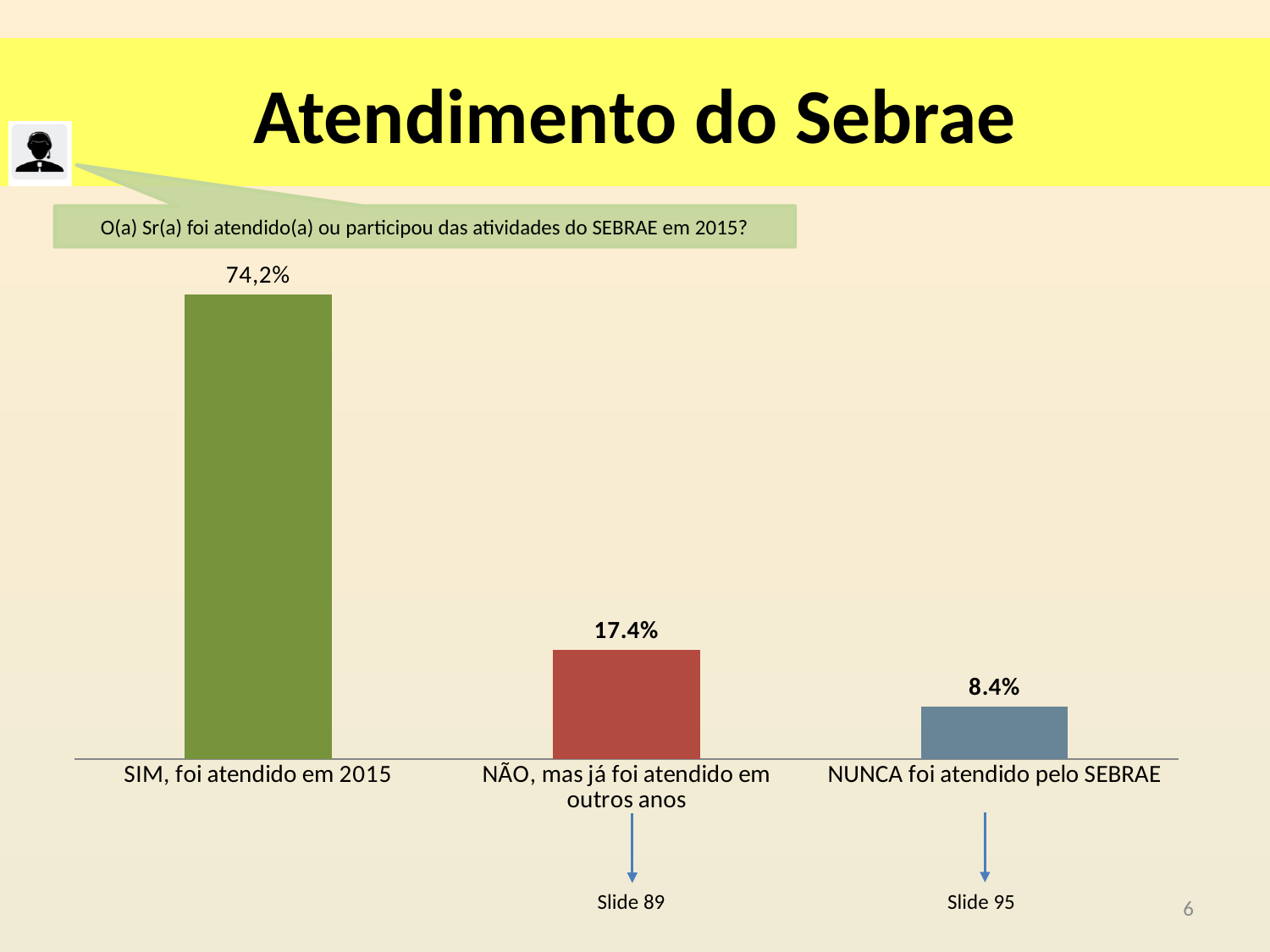
What colour is the bar for "SIM, foi atendido em 2015"? Green What kind of chart is shown on the slide? Bar chart Do the values rise or fall from left to right across the categories? Fall How many categories are shown in the chart? 3 Which is larger, the value for "NÃO, mas já foi atendido em outros anos" or the value for "NUNCA foi atendido pelo SEBRAE"? NÃO, mas já foi atendido em outros anos Which category has the highest value? SIM, foi atendido em 2015 What is the value for "NÃO, mas já foi atendido em outros anos"? 17.4% What is the title of the slide containing the chart? Atendimento do Sebrae What is the value for "SIM, foi atendido em 2015"? 74,2% What is the difference between the values for "NÃO, mas já foi atendido em outros anos" and "NUNCA foi atendido pelo SEBRAE"? 9.0% What is the value for "NUNCA foi atendido pelo SEBRAE"? 8.4% Which category has the lowest value? NUNCA foi atendido pelo SEBRAE